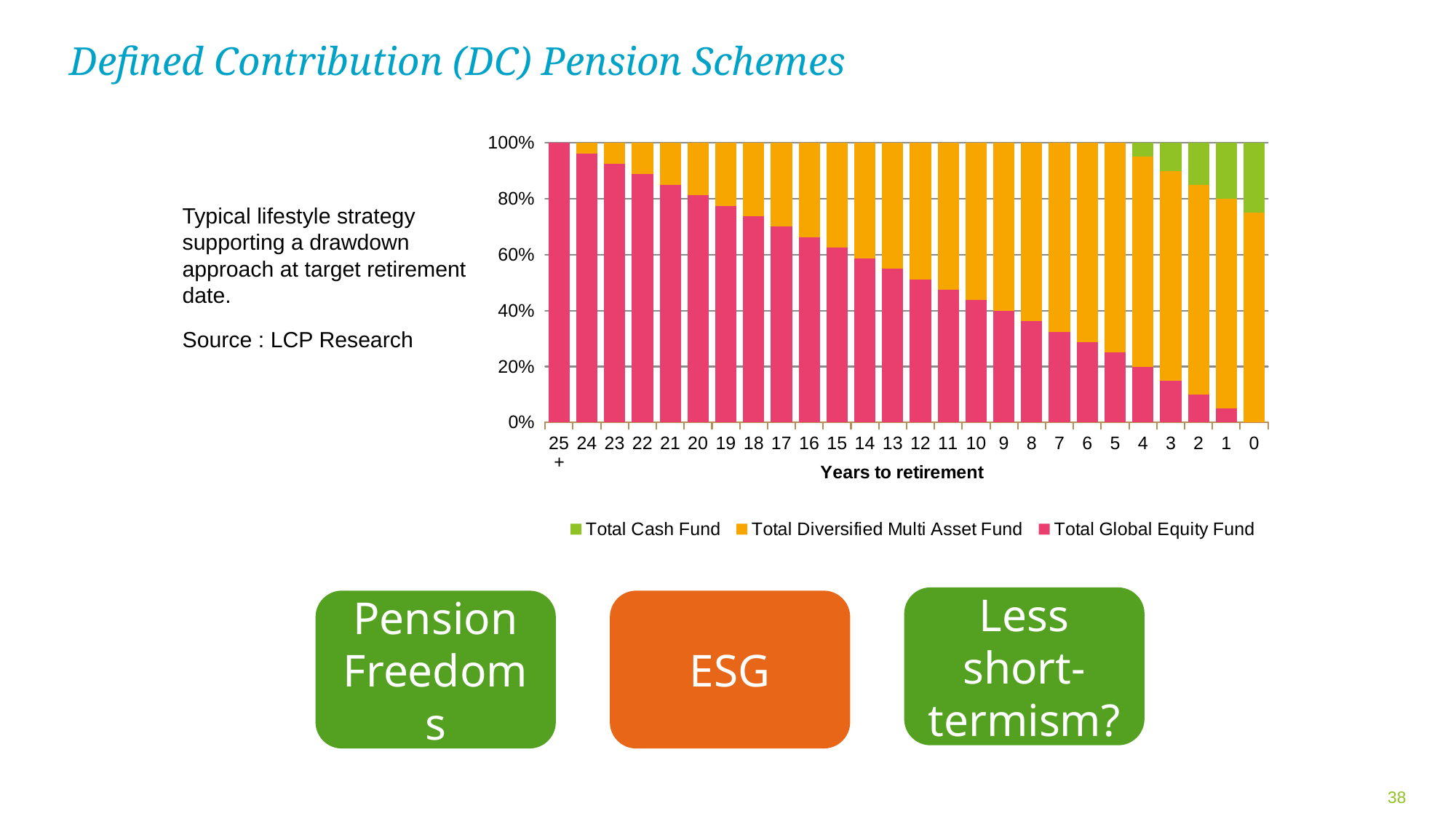
What is the title of the x axis of the chart? Years to retirement How many categories are shown along the x axis of the chart? 26 What kind of chart is shown on the slide? Stacked bar chart Which is larger: the Total Global Equity Fund share at 20 years to retirement or at 10 years to retirement? 20 years to retirement Which series is shown in green in the chart's legend? Total Cash Fund Is the Total Global Equity Fund value at 18 years to retirement greater or less than 80%? less Is the Total Global Equity Fund value at 10 years to retirement greater or less than 40%? greater What is the value of Total Global Equity Fund at 25+ years to retirement? 100% At which years-to-retirement category is the Total Cash Fund share highest? 0 How many series does the chart's legend list? 3 Does the Total Global Equity Fund share rise or fall as the years to retirement decrease from 25+ to 0? Fall At which years-to-retirement category is the Total Global Equity Fund share highest? 25+